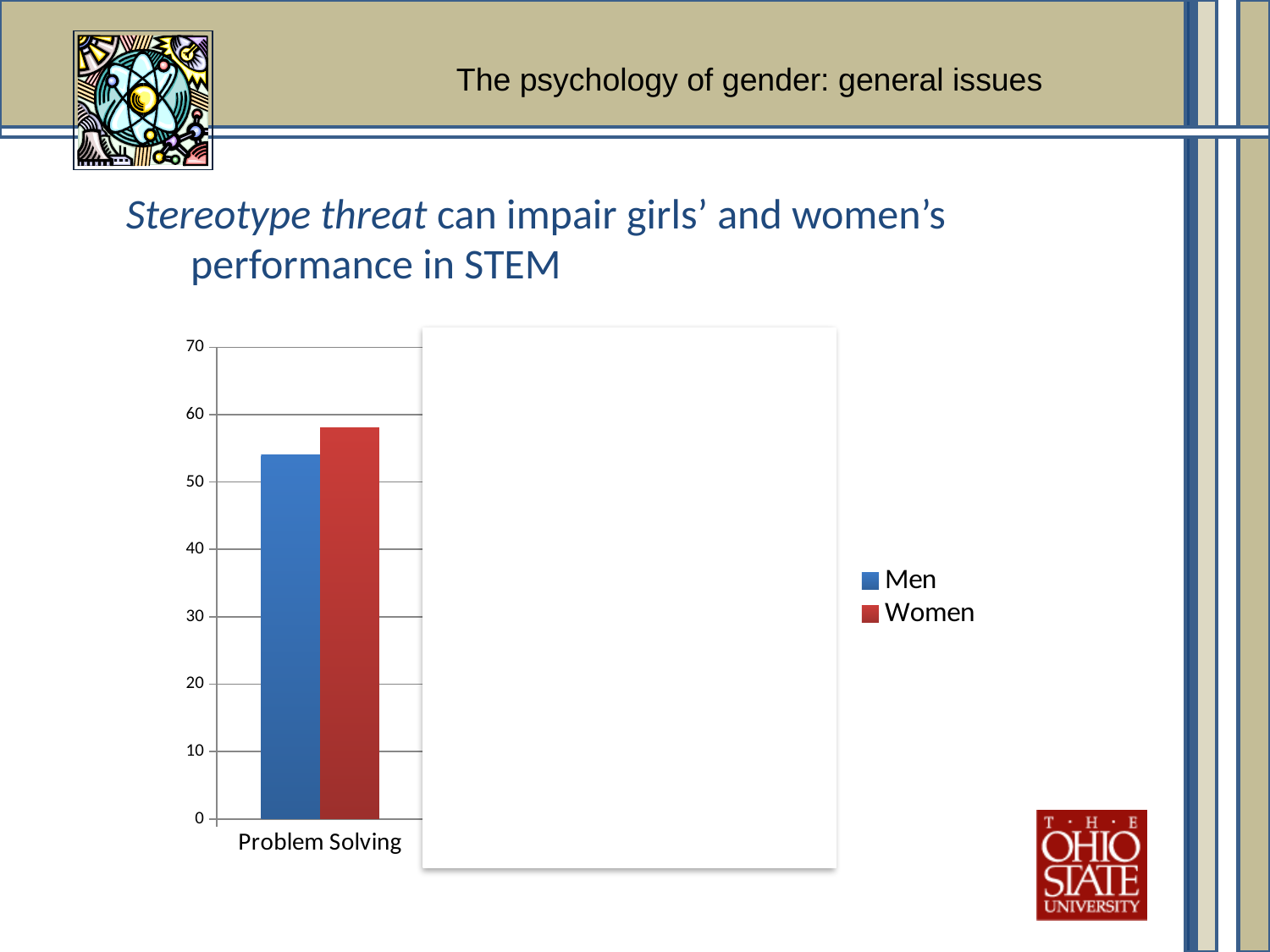
What is the category label shown beneath the visible bars? Problem Solving Which colour represents Women in the chart? red Is the value for Women in Problem Solving greater or less than 50? greater How many series does the chart's legend list? 2 What kind of chart is shown on the slide? bar chart Is the value for Women in Problem Solving greater or less than 60? less What is the highest value shown on the chart's vertical axis? 70 Is the value for Men in Problem Solving greater or less than 60? less What are the two series named in the chart's legend? Men and Women For Problem Solving, which series has the taller bar, Men or Women? Women